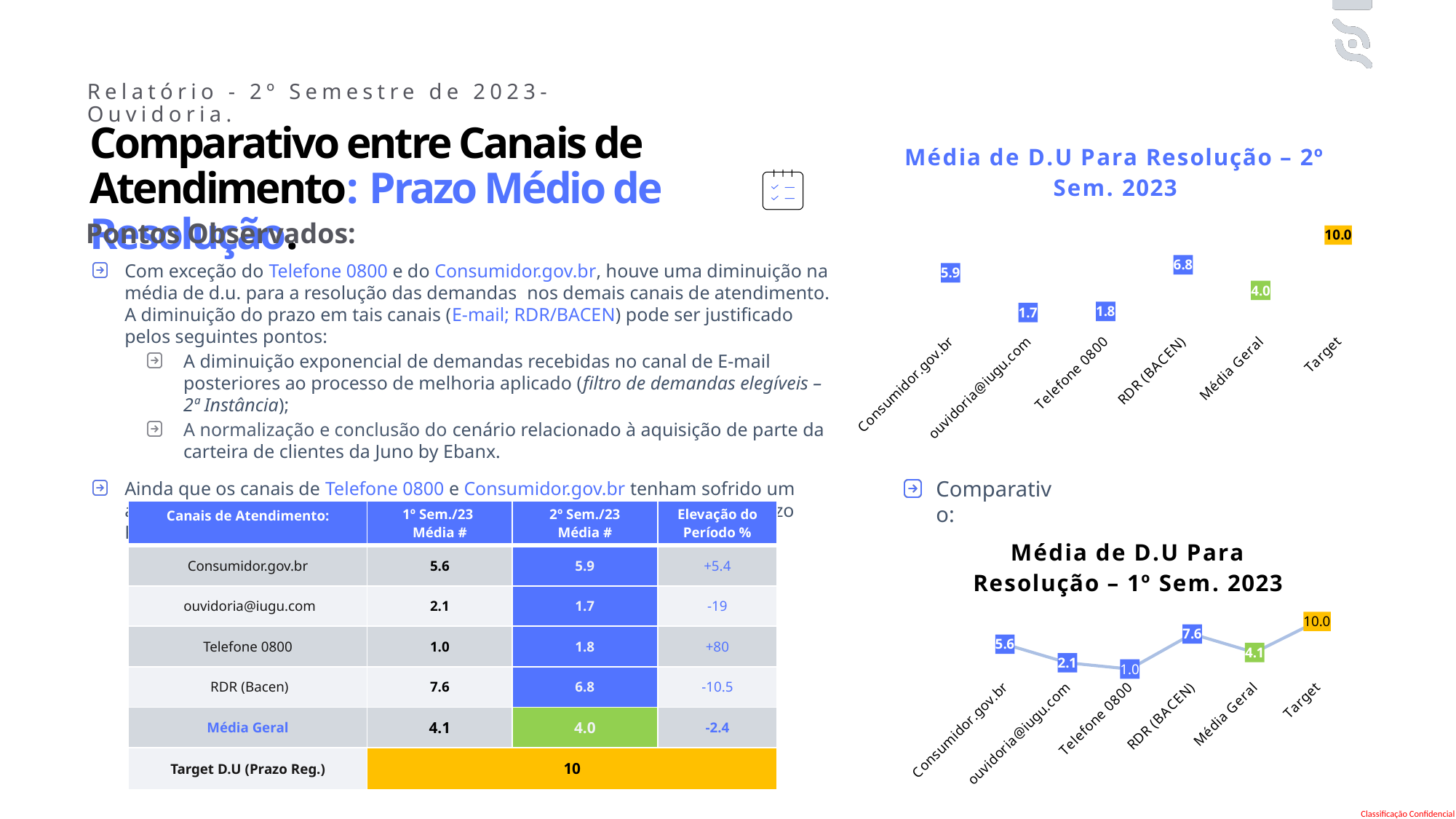
In the chart titled "Média de D.U Para Resolução – 1º Sem. 2023", which category has the lowest value? Telefone 0800 In the chart titled "Média de D.U Para Resolução – 2º Sem. 2023", what is the value for RDR (BACEN)? 6.8 In the chart titled "Média de D.U Para Resolução – 2º Sem. 2023", what is the value for ouvidoria@iugu.com? 1.7 In the chart titled "Média de D.U Para Resolução – 2º Sem. 2023", which category has the highest value? Target In the chart titled "Média de D.U Para Resolução – 1º Sem. 2023", what is the value for Telefone 0800? 1.0 In the chart titled "Média de D.U Para Resolução – 2º Sem. 2023", what is the difference between the values for RDR (BACEN) and Consumidor.gov.br? 0.9 In the chart titled "Média de D.U Para Resolução – 1º Sem. 2023", what is the value for Média Geral? 4.1 What kind of chart is the one titled "Média de D.U Para Resolução – 1º Sem. 2023"? Line chart In the chart titled "Média de D.U Para Resolução – 1º Sem. 2023", what is the difference between the values for Target and RDR (BACEN)? 2.4 In the chart titled "Média de D.U Para Resolução – 2º Sem. 2023", which category has the lowest value? ouvidoria@iugu.com In the chart titled "Média de D.U Para Resolução – 2º Sem. 2023", how many categories are plotted? 6 In the chart titled "Média de D.U Para Resolução – 1º Sem. 2023", which is larger, the value for RDR (BACEN) or the value for Consumidor.gov.br? RDR (BACEN)